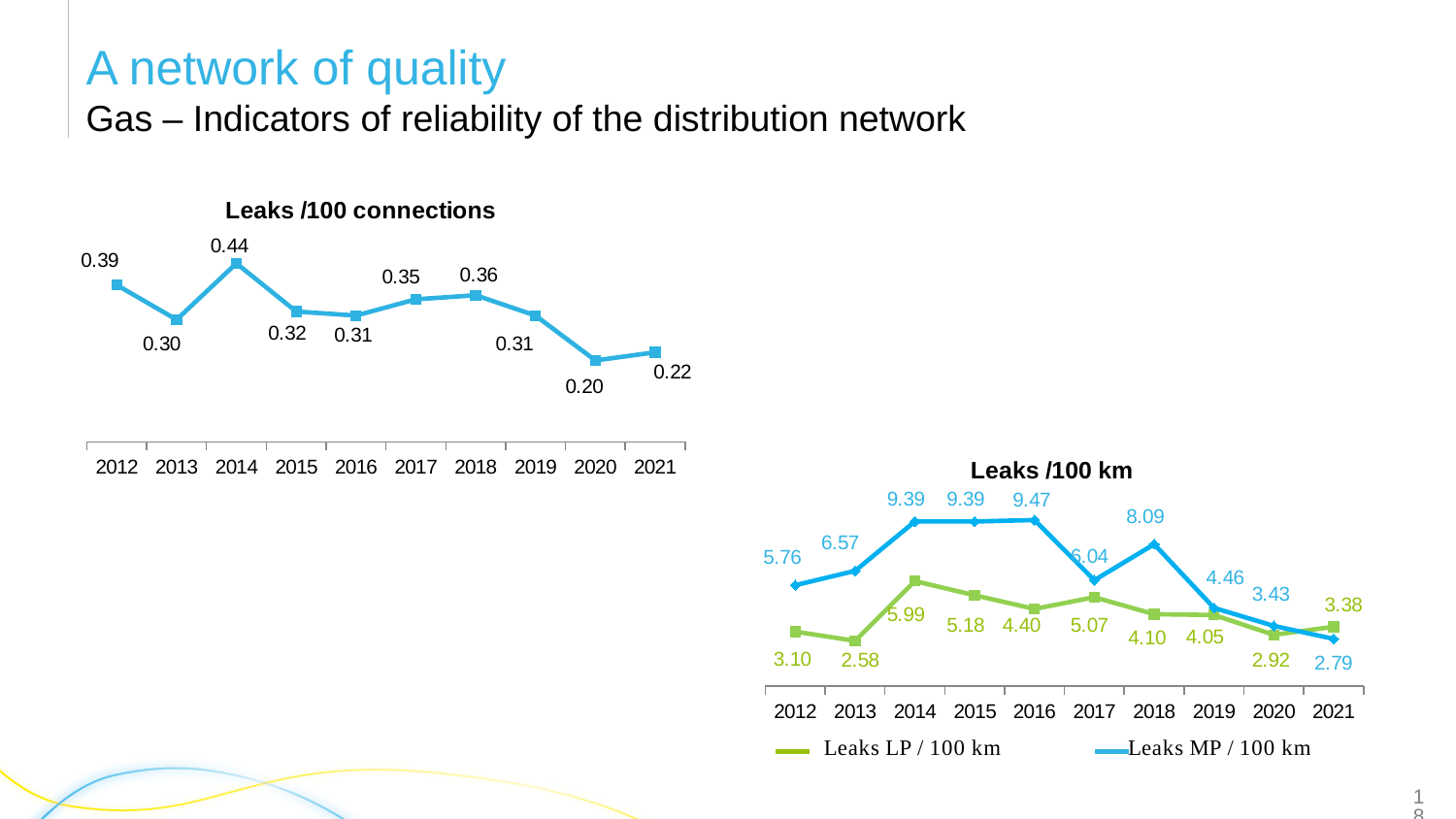
What kind of chart is the 'Leaks /100 connections' chart? Line chart In the 'Leaks /100 km' chart, what is the value of Leaks LP / 100 km in 2013? 2.58 In the 'Leaks /100 connections' chart, what is the value for 2014? 0.44 In the 'Leaks /100 connections' chart, how many years are plotted? 10 In the 'Leaks /100 connections' chart, what is the difference between the 2012 value and the 2021 value? 0.17 In the 'Leaks /100 km' chart, what is the difference between Leaks MP / 100 km and Leaks LP / 100 km in 2014? 3.40 In the 'Leaks /100 connections' chart, which year has the lowest value? 2020 In the 'Leaks /100 km' chart, which is larger in 2021: Leaks LP / 100 km or Leaks MP / 100 km? Leaks LP / 100 km In the 'Leaks /100 km' chart, which year has the highest value for Leaks MP / 100 km? 2016 In the 'Leaks /100 connections' chart, which year has the highest value? 2014 In the 'Leaks /100 km' chart, what is the value of Leaks MP / 100 km in 2018? 8.09 How many series does the legend of the 'Leaks /100 km' chart list? 2